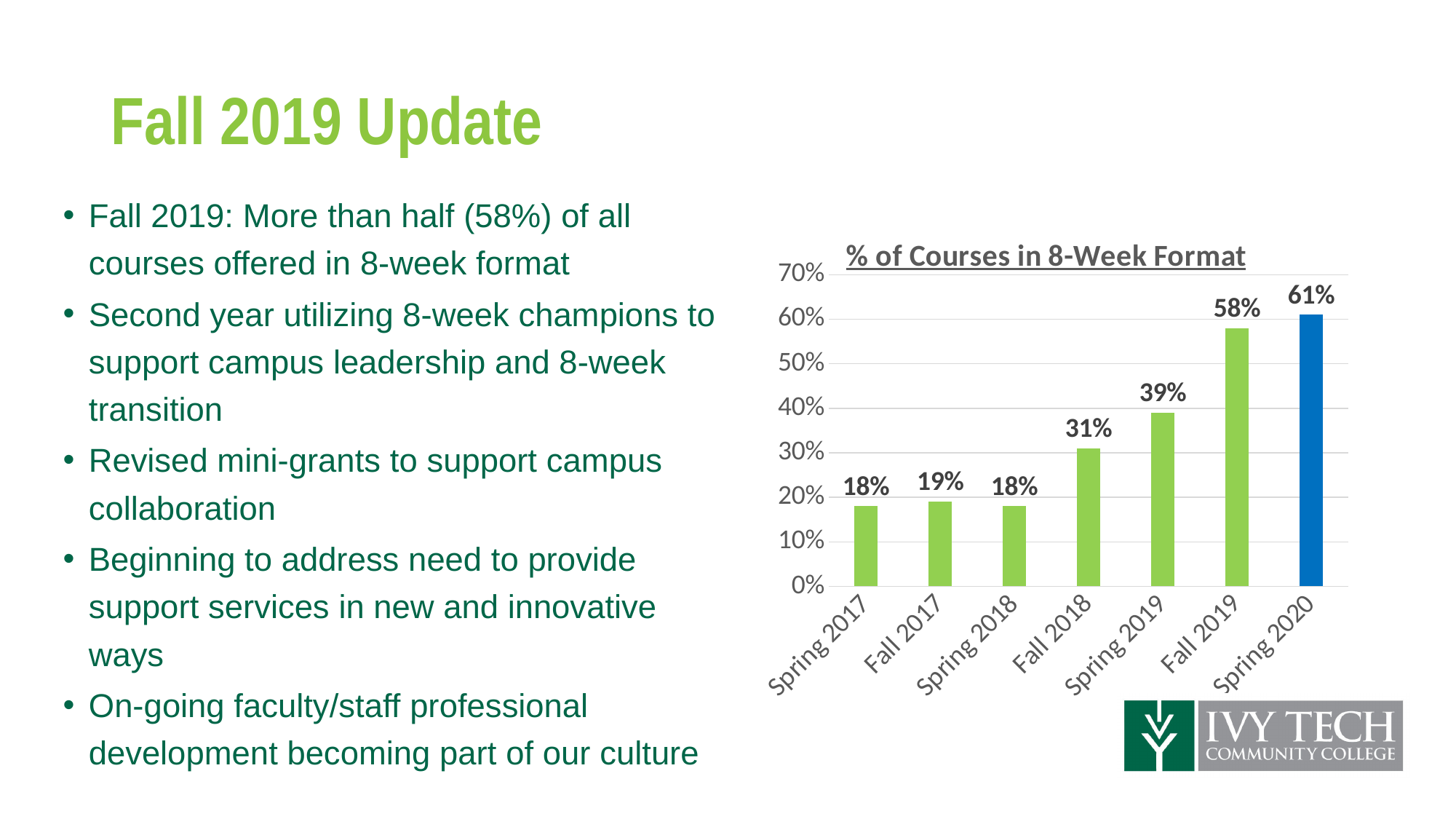
What is the difference between the values for Spring 2019 and Fall 2018? 8% What is the value for Spring 2020 in the chart? 61% Do the values generally rise or fall from Spring 2018 to Spring 2020? Rise What is the value for Fall 2019 in the chart? 58% Which category has the highest value in the chart? Spring 2020 What kind of chart is shown on the slide? Bar chart How many categories are shown on the x axis of the chart? 7 What is the value for Fall 2018 in the chart? 31% Which is larger, the value for Fall 2017 or the value for Spring 2018? Fall 2017 What is the difference between the values for Spring 2020 and Fall 2019? 3% Is the value for Spring 2019 greater or less than 30%? greater What is the title of the chart? % of Courses in 8-Week Format